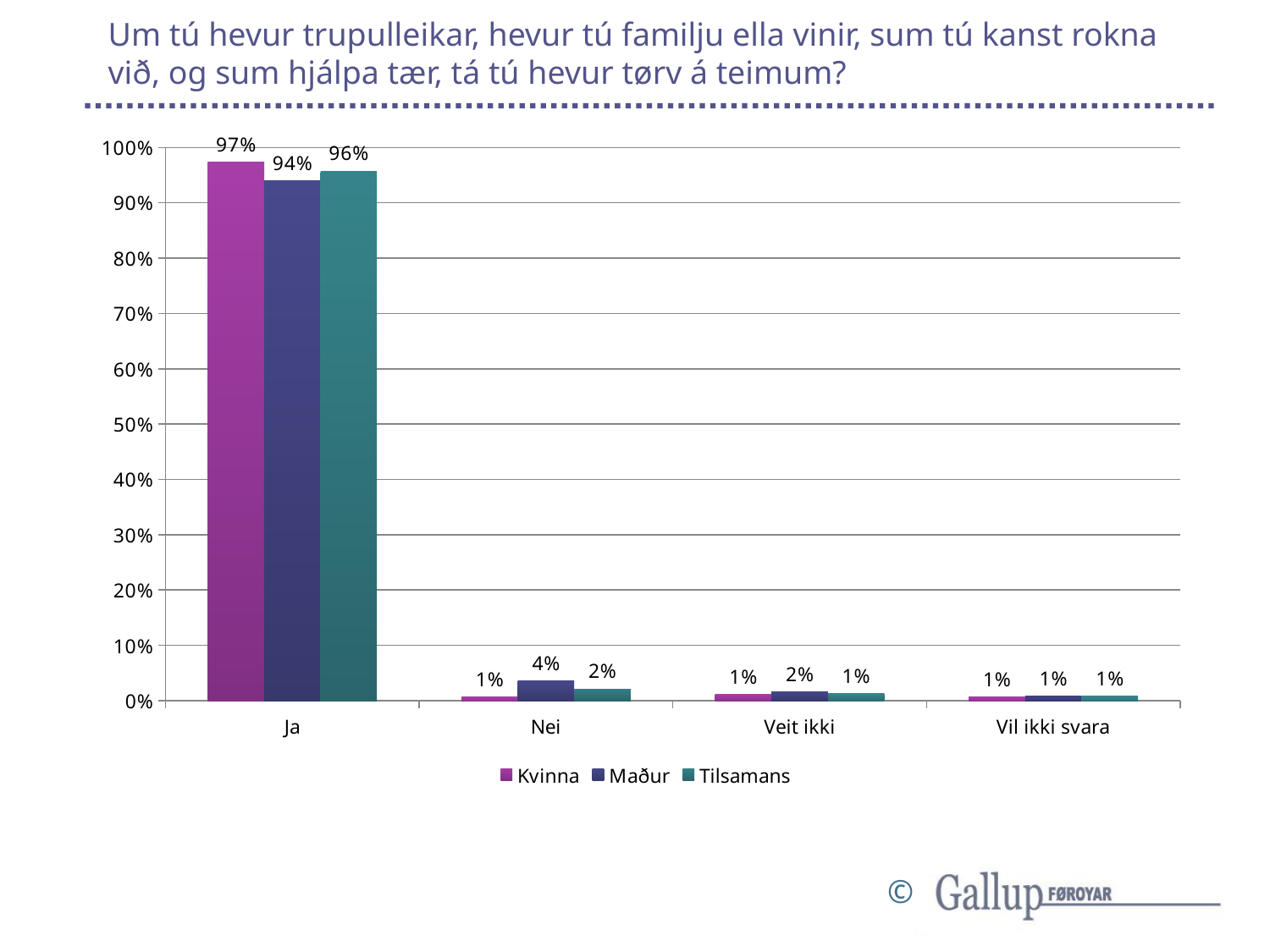
What is the value for Maður in the Veit ikki category? 2% What is the value for Maður in the Nei category? 4% How many categories are shown on the x axis? 4 How many series does the legend list? 3 What is the value for Tilsamans in the Ja category? 96% Which category has the highest value for the Tilsamans series? Ja Which is larger in the Ja category, the Kvinna value or the Maður value? Kvinna What kind of chart is shown on the slide? bar chart What is the difference between the Maður and Kvinna values in the Nei category? 3% Is the value for Maður in the Ja category greater or less than 90%? greater What is the value for Kvinna in the Ja category? 97% What is the difference between the Kvinna and Maður values in the Ja category? 3%